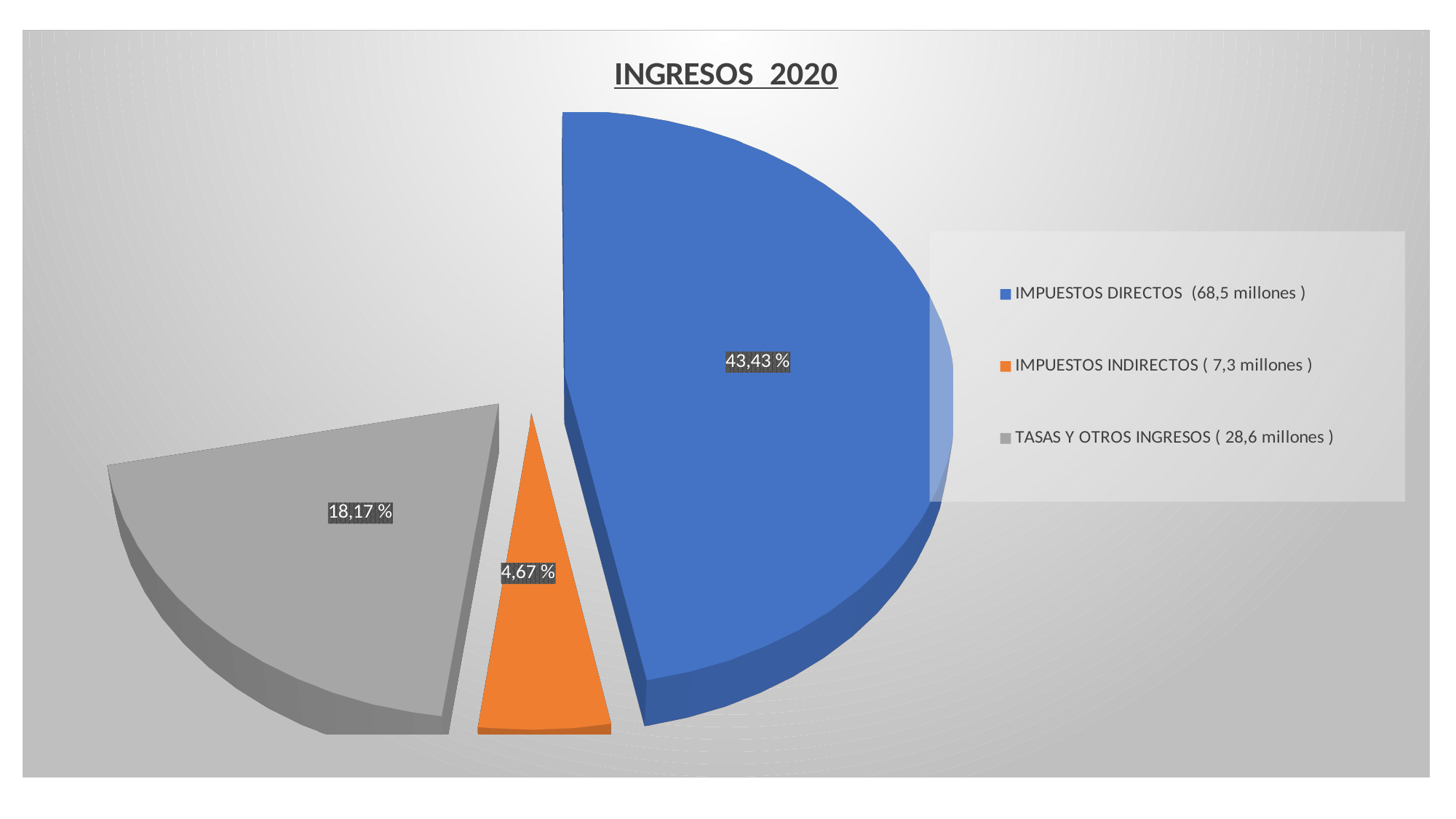
Which category has the smallest slice of the pie? IMPUESTOS INDIRECTOS What percentage is shown for TASAS Y OTROS INGRESOS? 18,17 % According to the legend, how many millones correspond to IMPUESTOS DIRECTOS? 68,5 millones What is the difference in percentage points between IMPUESTOS DIRECTOS and TASAS Y OTROS INGRESOS? 25,26 % What percentage is shown for IMPUESTOS INDIRECTOS? 4,67 % What is the title of the chart? INGRESOS 2020 How many categories does the legend list? 3 According to the legend, how many millones correspond to TASAS Y OTROS INGRESOS? 28,6 millones What colour is the slice for IMPUESTOS INDIRECTOS? Orange Which category has the largest slice of the pie? IMPUESTOS DIRECTOS What kind of chart is shown on the slide? Pie chart What percentage is shown for IMPUESTOS DIRECTOS? 43,43 %